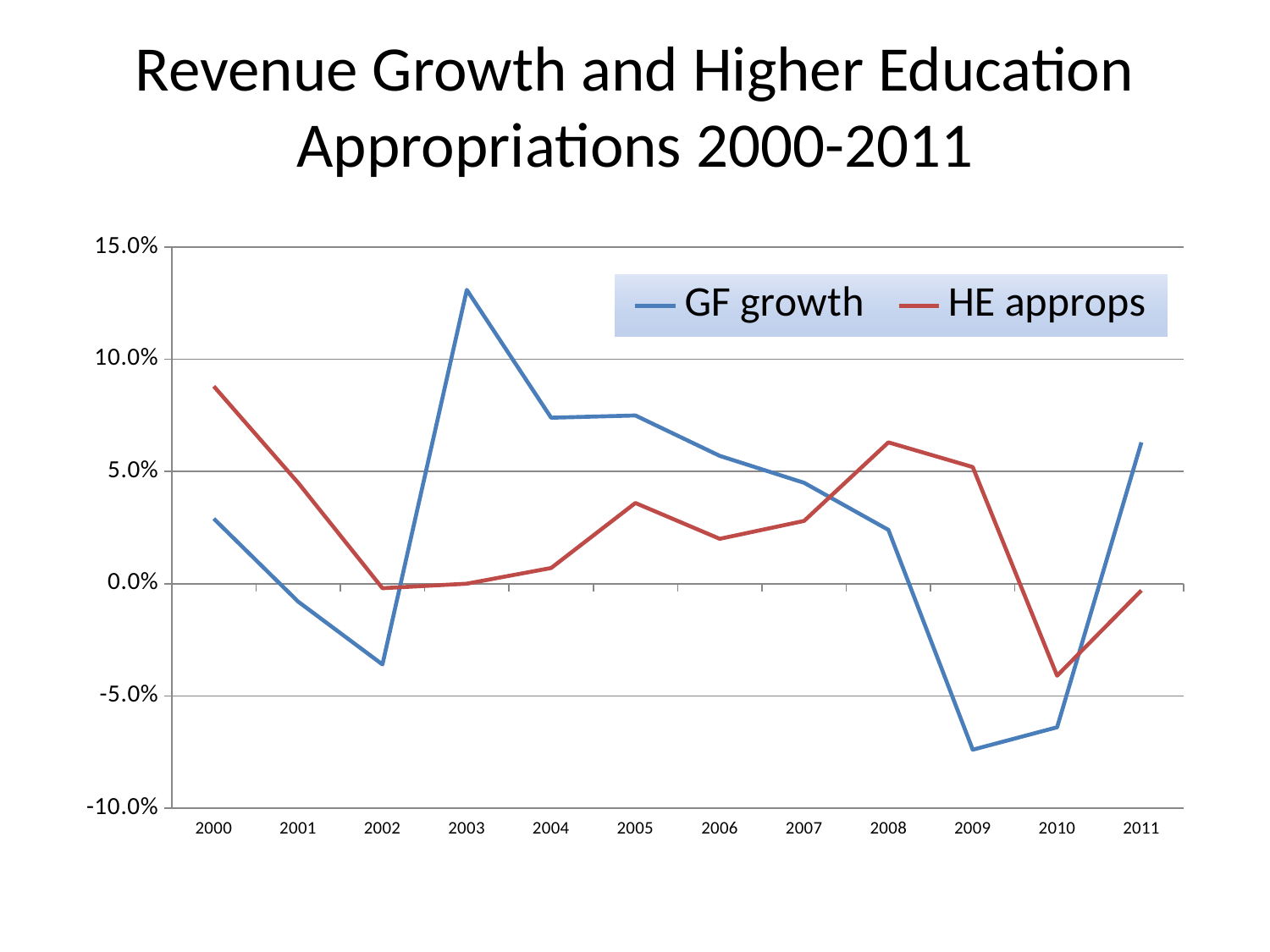
What is the title of the chart? Revenue Growth and Higher Education Appropriations 2000-2011 How many series does the legend list? 2 In which year does GF growth reach its highest value? 2003 In which year does GF growth reach its lowest value? 2009 How many years are plotted along the x axis? 12 Does GF growth rise or fall from 2005 to 2009? fall In 2000, which series has the higher value, GF growth or HE approps? HE approps In which year is HE approps at its lowest? 2010 What kind of chart is shown on the slide? line chart Is the value for GF growth in 2009 greater or less than -5.0%? less Is the value for GF growth in 2003 greater or less than 10.0%? greater In which year is HE approps at its highest? 2000